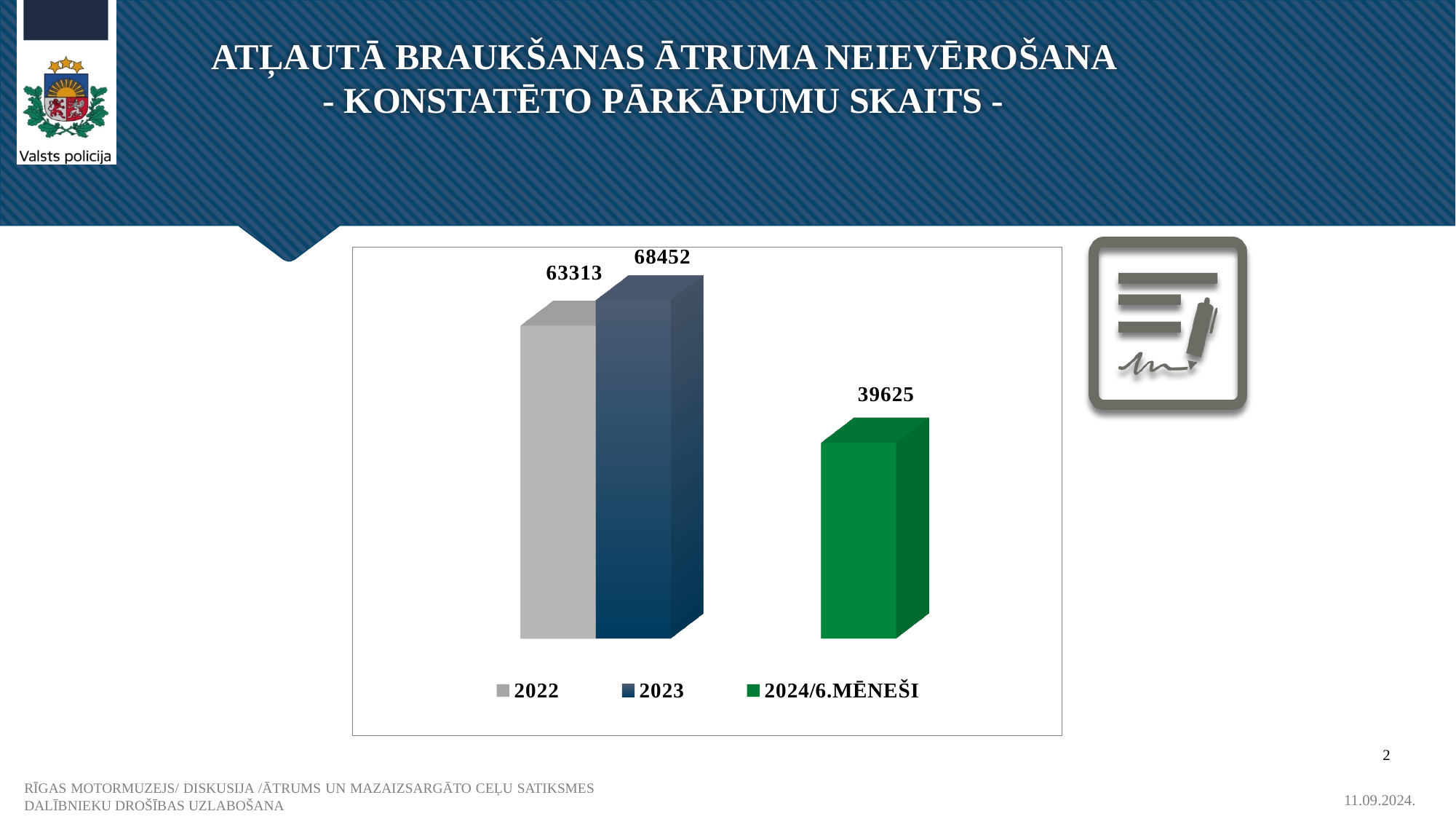
What is the value for 2023? 68452 What colour is the bar for 2024/6.MĒNEŠI? green What is the difference between the 2022 and 2024/6.MĒNEŠI values? 23688 What is the value for 2024/6.MĒNEŠI? 39625 How many series does the legend list? 3 Which series has the highest value? 2023 What is the value for 2022? 63313 Which is larger, the value for 2022 or the value for 2024/6.MĒNEŠI? 2022 Which series has the lowest value? 2024/6.MĒNEŠI What is the difference between the 2023 and 2022 values? 5139 How many bars are plotted in the chart? 3 What kind of chart is shown on the slide? bar chart